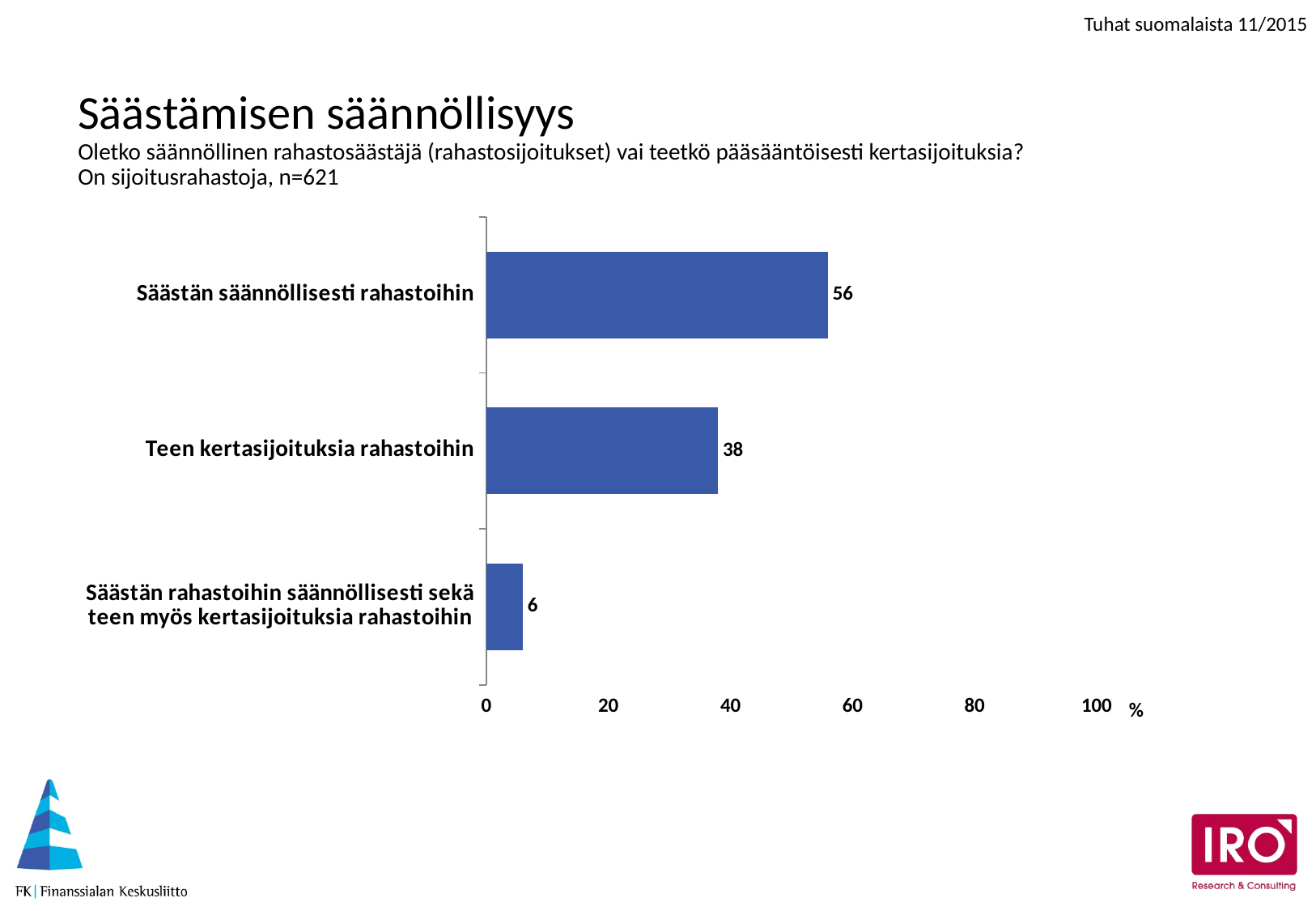
What is the difference between the values for "Säästän säännöllisesti rahastoihin" and "Teen kertasijoituksia rahastoihin"? 18 Is the value for "Säästän säännöllisesti rahastoihin" greater or less than 40? greater Which is larger: the value for "Teen kertasijoituksia rahastoihin" or the value for "Säästän rahastoihin säännöllisesti sekä teen myös kertasijoituksia rahastoihin"? Teen kertasijoituksia rahastoihin What is the value for "Teen kertasijoituksia rahastoihin"? 38 Which category has the highest value? Säästän säännöllisesti rahastoihin What is the value for "Säästän rahastoihin säännöllisesti sekä teen myös kertasijoituksia rahastoihin"? 6 What is the title of the slide? Säästämisen säännöllisyys What is the value for "Säästän säännöllisesti rahastoihin"? 56 How many categories are shown in the chart? 3 Which category has the lowest value? Säästän rahastoihin säännöllisesti sekä teen myös kertasijoituksia rahastoihin What kind of chart is shown on the slide? bar chart Is the value for "Teen kertasijoituksia rahastoihin" greater or less than 40? less